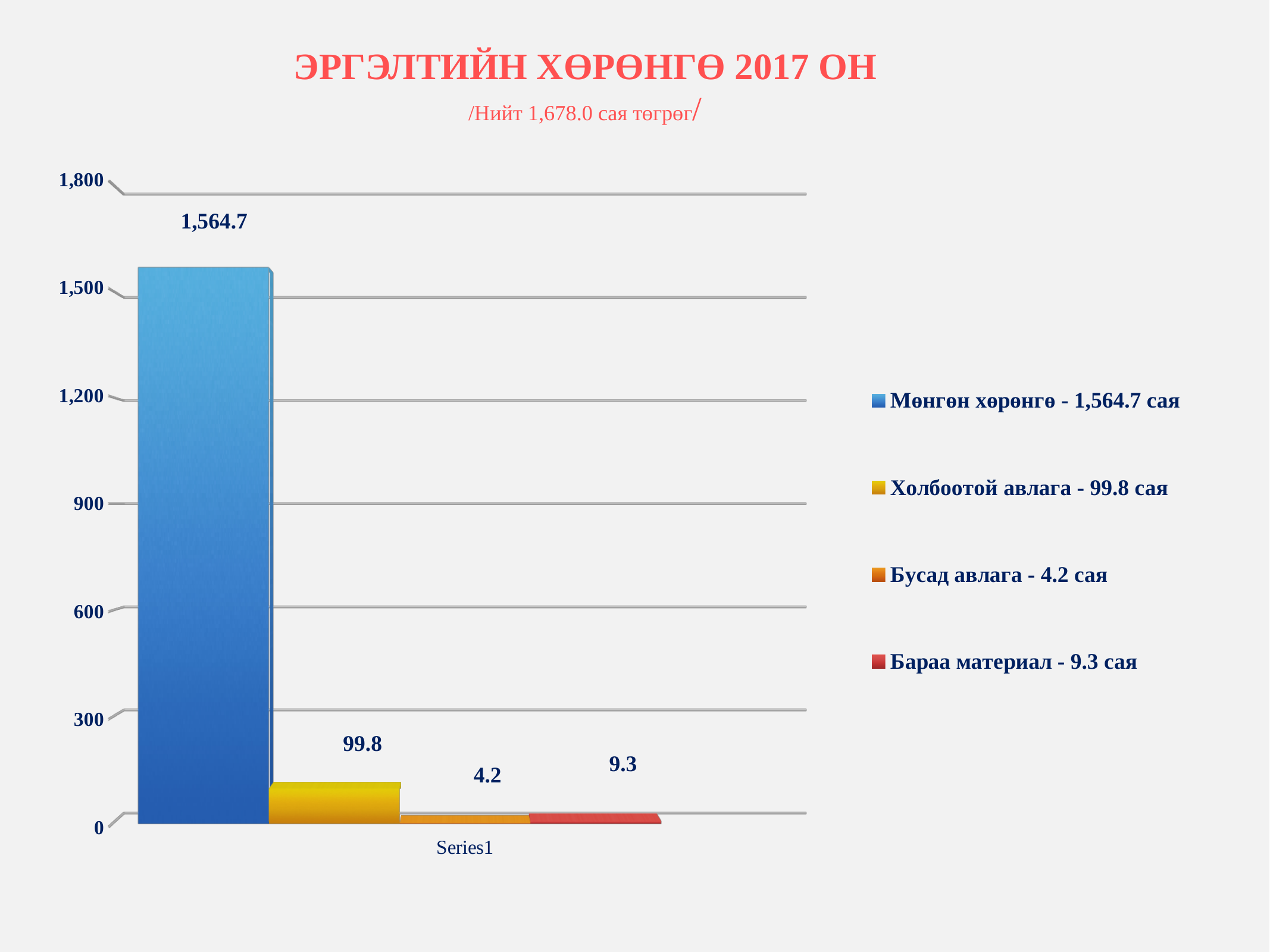
Is the value for Мөнгөн хөрөнгө greater or less than 1,500? greater What is the value for Бусад авлага? 4.2 What is the title of the chart on the slide? ЭРГЭЛТИЙН ХӨРӨНГӨ 2017 ОН How many series does the legend list? 4 Which category has the lowest value? Бусад авлага What is the difference between the values for Мөнгөн хөрөнгө and Холбоотой авлага? 1,464.9 What is the value for Мөнгөн хөрөнгө? 1,564.7 Which category has the highest value? Мөнгөн хөрөнгө What is the value for Холбоотой авлага? 99.8 What kind of chart is shown on the slide? bar chart What is the value for Бараа материал? 9.3 Which is larger, the value for Бараа материал or the value for Бусад авлага? Бараа материал